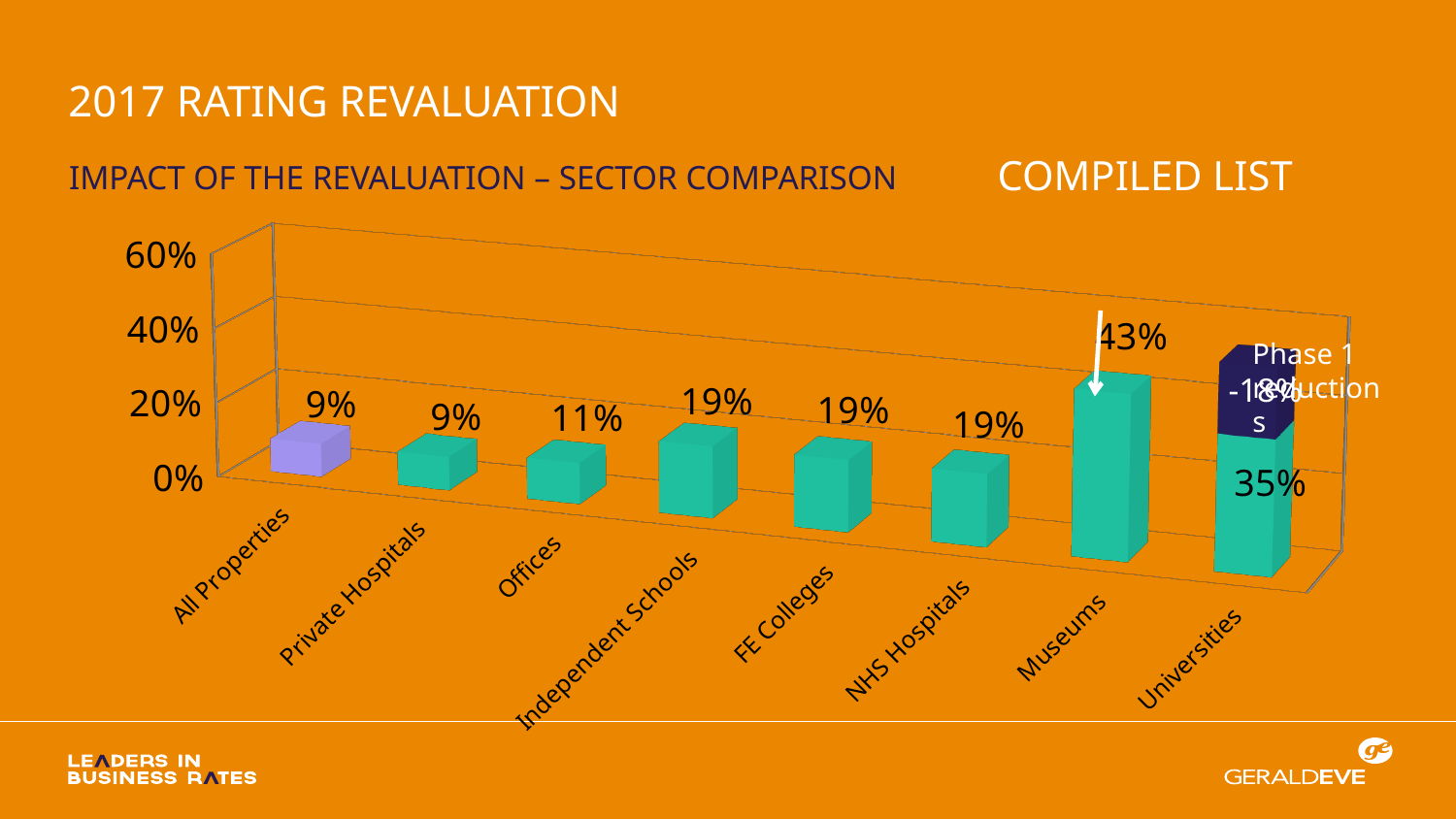
What is the value for Independent Schools? 19% What is the value for Offices? 11% What is the difference between the value for Museums and the green bar value for Universities? 8% What is the value shown on the green bar for Universities? 35% What is the value for Museums? 43% What is the difference between the values for Independent Schools and Private Hospitals? 10% Is the value for Museums greater or less than 40%? greater What is the value for All Properties? 9% Which is larger, the value for Museums or the value for NHS Hospitals? Museums What kind of chart is shown on the slide? Bar chart How many sectors are shown on the x axis? 8